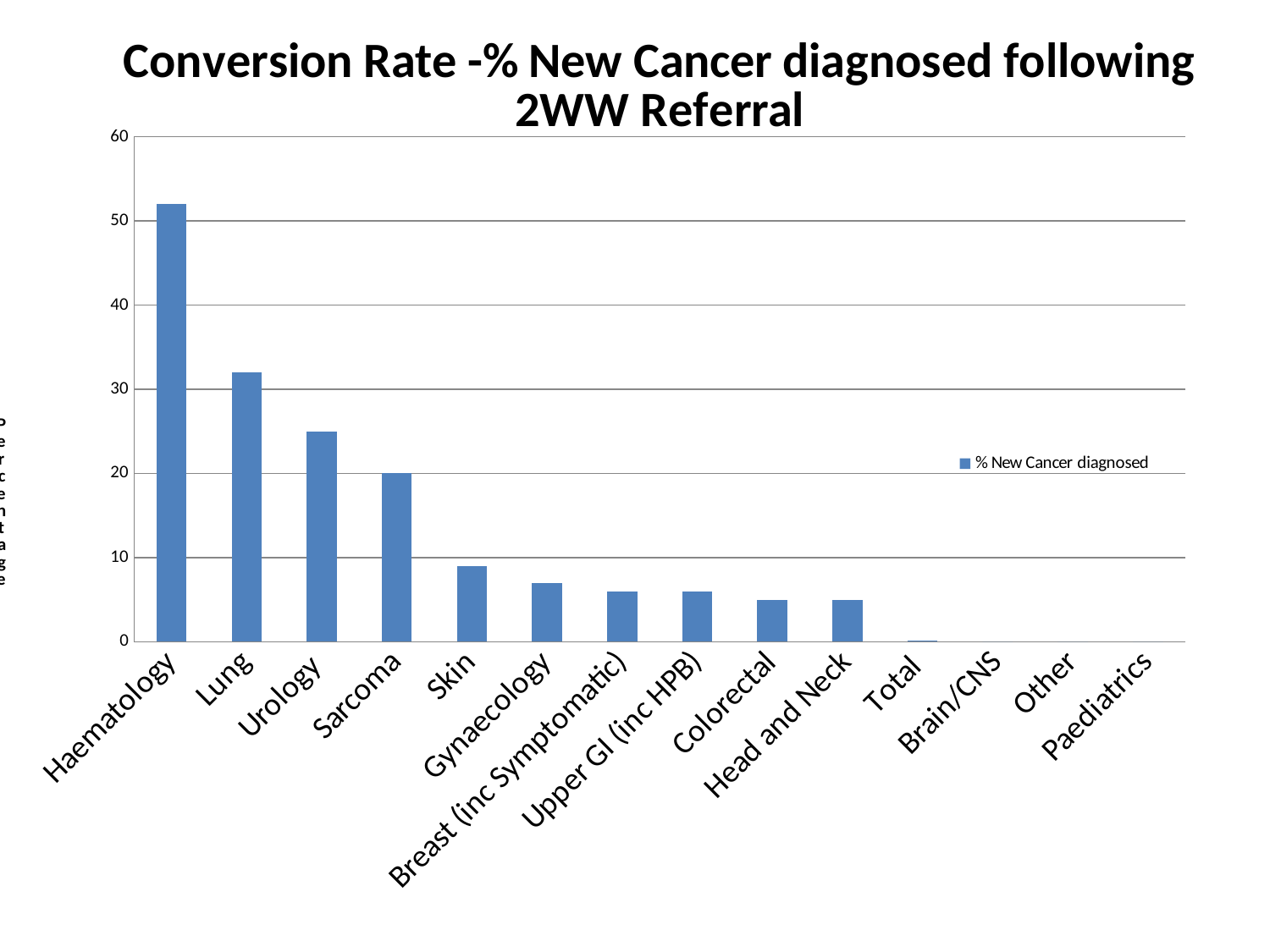
What kind of chart is shown on the slide? bar chart What is the % New Cancer diagnosed value for Sarcoma? 20 Which has a larger value, Lung or Urology? Lung How many series does the legend list? 1 Is the value for Skin greater or less than 10? less Is the value for Haematology greater or less than 50? greater Which category has the highest % New Cancer diagnosed? Haematology Which has a larger value, Sarcoma or Skin? Sarcoma Is the value for Urology greater or less than 30? less Do the values generally rise or fall from left to right along the x axis? fall How many categories are shown on the x axis? 14